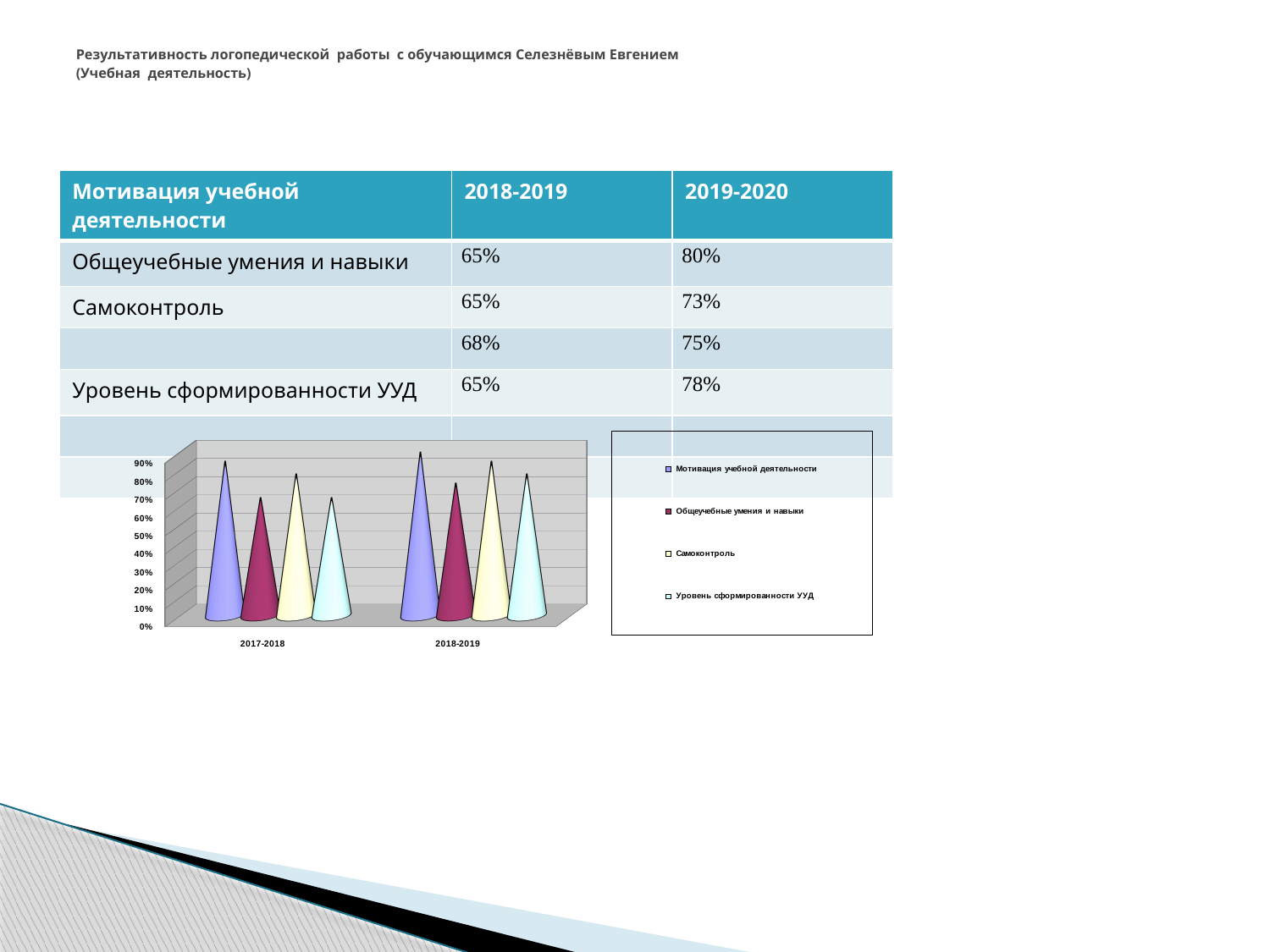
Which series is shown in blue in the chart legend? Мотивация учебной деятельности What kind of chart is shown on the slide? bar chart Which series has the highest value in 2017-2018? Мотивация учебной деятельности What are the two categories on the x axis of the chart? 2017-2018 and 2018-2019 Does the value for Мотивация учебной деятельности rise or fall from 2017-2018 to 2018-2019? rise Is the value for Общеучебные умения и навыки in 2017-2018 greater or less than 90%? less Is the value for Мотивация учебной деятельности in 2017-2018 greater or less than 50%? greater Which series has the highest value in 2018-2019? Мотивация учебной деятельности In 2017-2018, which is larger: Мотивация учебной деятельности or Общеучебные умения и навыки? Мотивация учебной деятельности How many series does the chart legend list? 4 Is the value for Самоконтроль in 2018-2019 greater or less than 40%? greater How many categories are shown on the x axis of the chart? 2